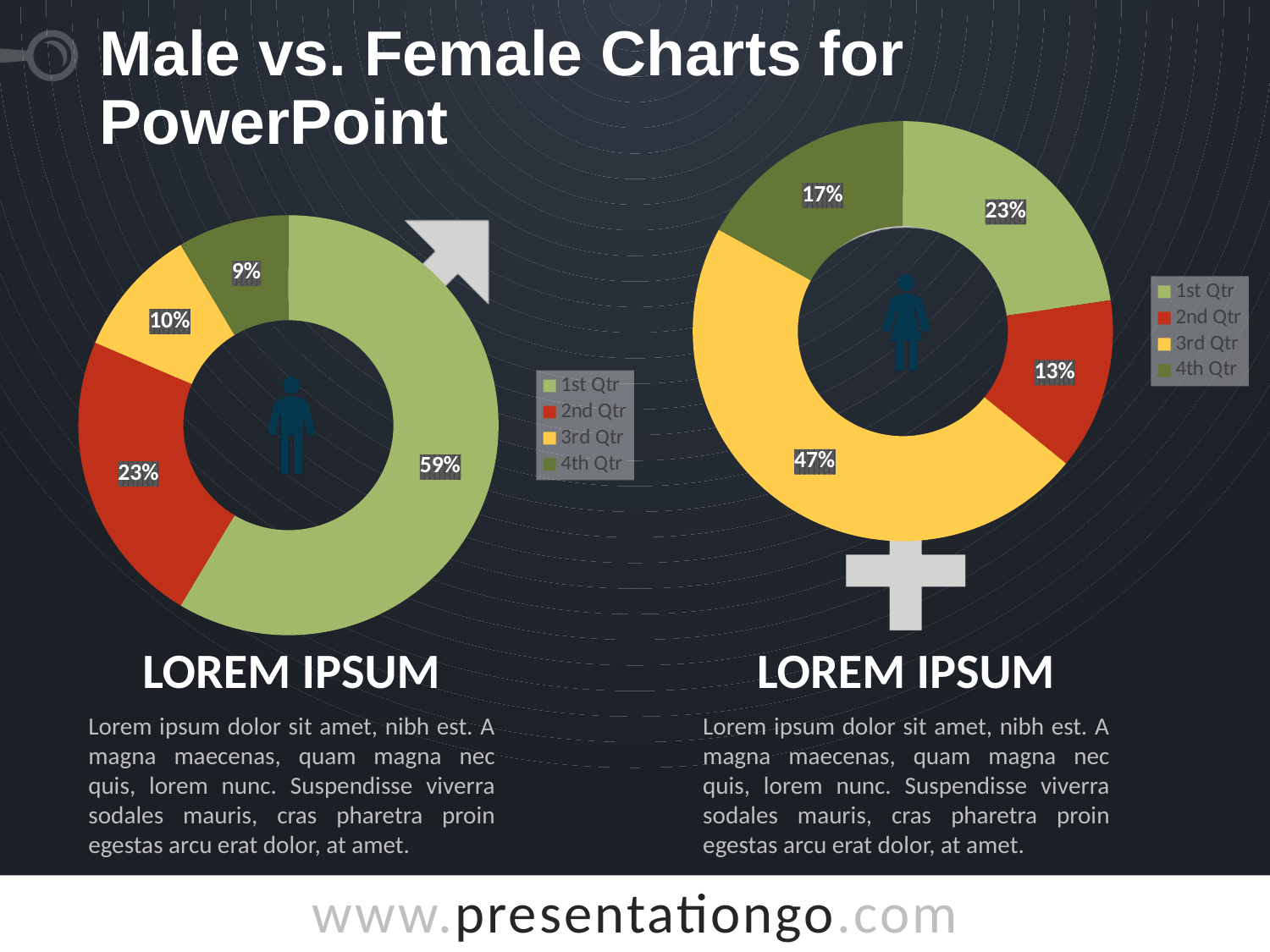
In the left (male) doughnut chart, which quarter has the smallest share? 4th Qtr In the right (female) doughnut chart, which quarter has the smallest share? 2nd Qtr How many series does the legend of the right (female) doughnut chart list? 4 In the left (male) doughnut chart, what is the value for 1st Qtr? 59% In the left (male) doughnut chart, what is the value for 2nd Qtr? 23% In the right (female) doughnut chart, what is the value for 3rd Qtr? 47% In the right (female) doughnut chart, what is the value for 4th Qtr? 17% Which chart has the larger value for 2nd Qtr, the left (male) chart or the right (female) chart? the left (male) chart What type of chart is used on the left side of the slide? doughnut chart In the left (male) doughnut chart, which quarter has the largest share? 1st Qtr In the left (male) doughnut chart, what is the difference between the 3rd Qtr and 4th Qtr values? 1% In the right (female) doughnut chart, what is the difference between the 3rd Qtr and 1st Qtr values? 24%